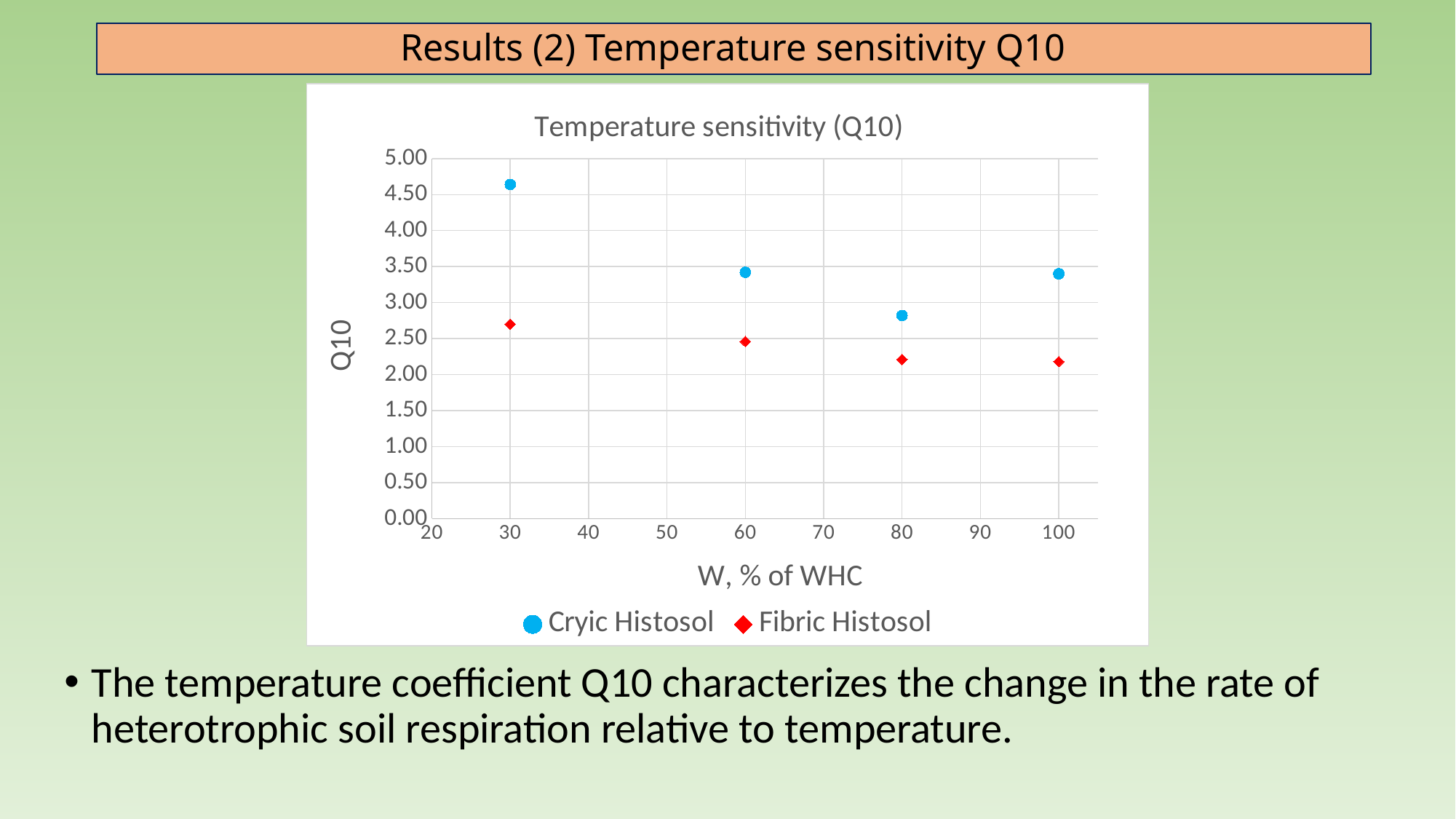
Is the Q10 value for Fibric Histosol at W = 30 greater or less than 2.50? greater What kind of chart is shown on the slide? scatter chart How many data points are plotted for the Cryic Histosol series? 4 Is the Q10 value for Cryic Histosol at W = 30 greater or less than 4.00? greater What is the label of the x axis of the chart? W, % of WHC At which W value (% of WHC) is the Q10 for Fibric Histosol highest? 30 At which W value (% of WHC) is the Q10 for Cryic Histosol highest? 30 Do the Q10 values for Fibric Histosol rise or fall as W increases from 30 to 100? fall At W = 60, which series has the larger Q10 value, Cryic Histosol or Fibric Histosol? Cryic Histosol Is the Q10 value for Cryic Histosol at W = 80 greater or less than 3.00? less How many series does the legend list? 2 At which W value (% of WHC) is the Q10 for Cryic Histosol lowest? 80